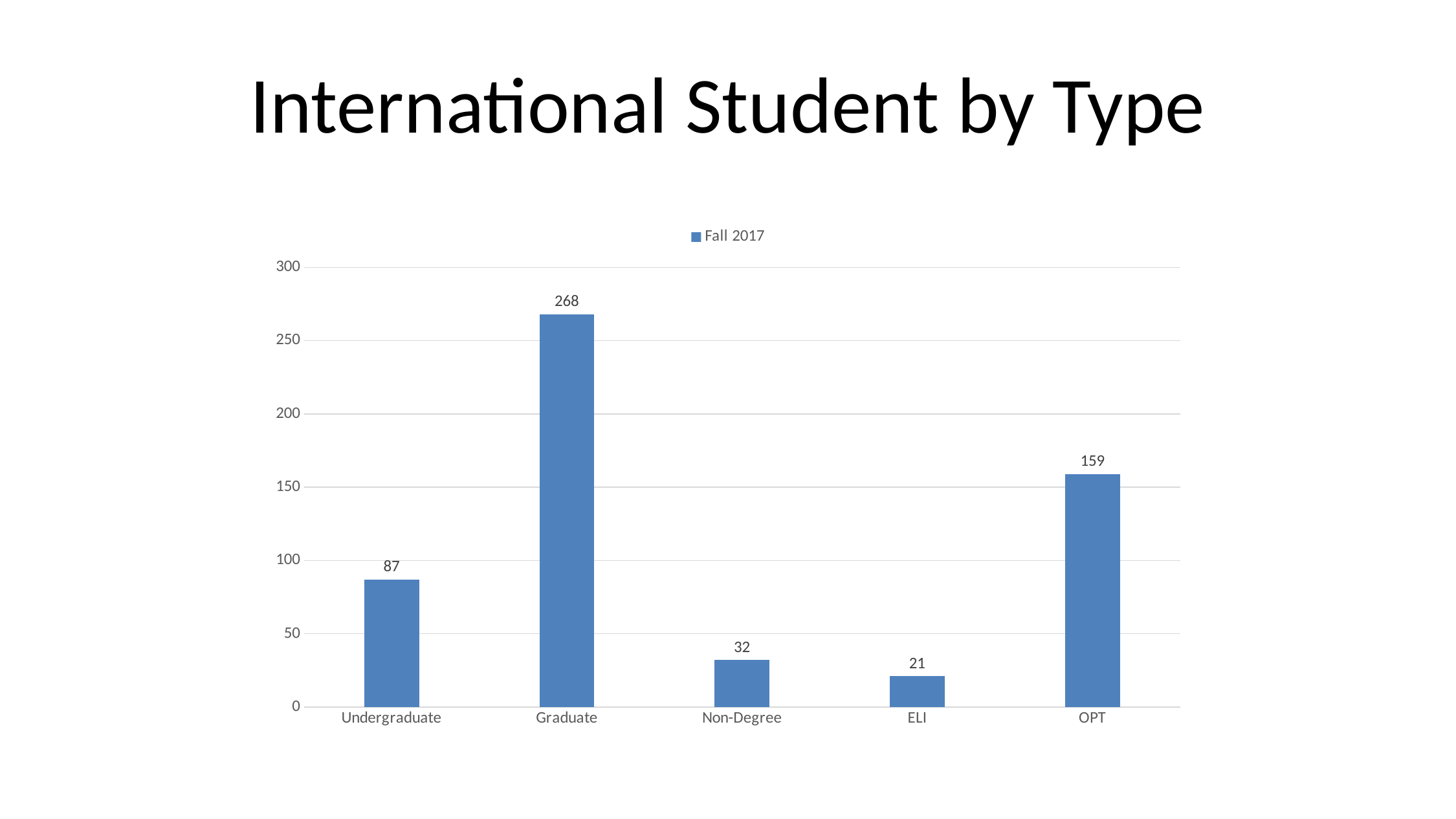
What is the value for Graduate students in Fall 2017? 268 What is the value for OPT in Fall 2017? 159 What kind of chart is shown on the slide? Bar chart Which is larger, the value for Undergraduate or the value for OPT? OPT Which student type has the lowest value? ELI How many student types are shown on the x axis? 5 What is the difference between the Non-Degree and ELI values? 11 Which student type has the highest value? Graduate How many series does the legend list? 1 What is the value for Undergraduate students in Fall 2017? 87 What is the value for ELI in Fall 2017? 21 What is the difference between the Graduate and OPT values? 109